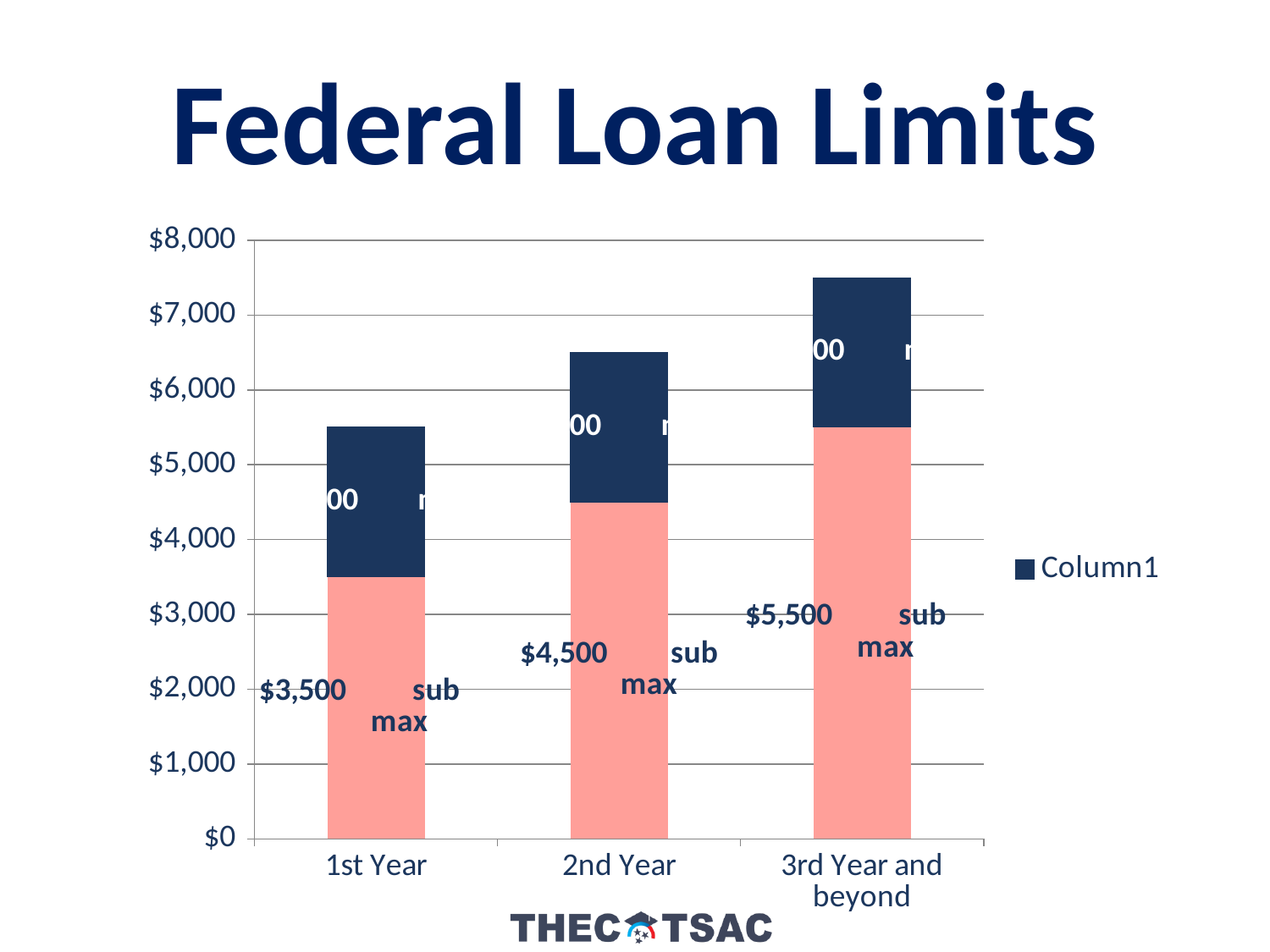
What is the sub max value shown for 2nd Year? $4,500 Do the bar totals rise or fall from 1st Year to 3rd Year and beyond? Rise How many categories are shown on the x axis? 3 What is the sub max value shown for 3rd Year and beyond? $5,500 What is the sub max value shown for 1st Year? $3,500 Is the total height of the 3rd Year and beyond bar greater or less than $7,000? greater What is the difference between the sub max values for 3rd Year and beyond and 1st Year? $2,000 Which category has the lowest sub max value? 1st Year Which category has the highest sub max value? 3rd Year and beyond What kind of chart is shown on the slide? Bar chart Which is larger, the sub max value for 2nd Year or for 1st Year? 2nd Year Is the total height of the 1st Year bar greater or less than $6,000? less